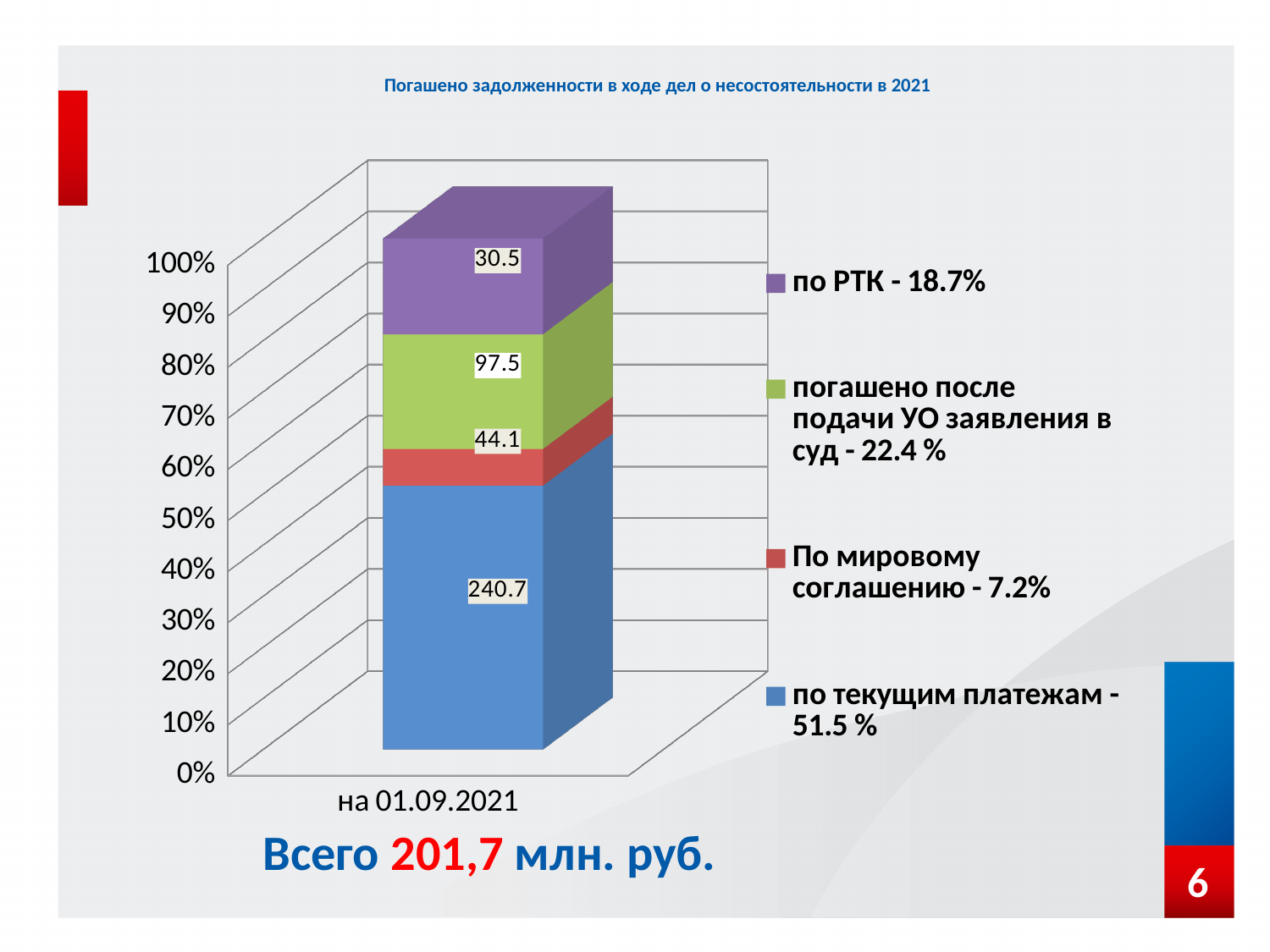
What is the data label for the 'погашено после подачи УО заявления в суд' segment? 97.5 What is the difference between the 'погашено после подачи УО заявления в суд' label (97.5) and the 'по РТК' label (30.5)? 67 What kind of chart is shown on the slide? Stacked bar chart Which is larger: the 'По мировому соглашению' label or the 'по РТК' label? По мировому соглашению Which series has the smallest data label in the stacked bar? по РТК What is the data label for the 'по РТК' segment of the stacked bar? 30.5 How many series does the legend list? 4 Which series has the largest data label in the stacked bar? по текущим платежам What is the data label for the 'по текущим платежам' segment of the stacked bar? 240.7 What percentage does the legend give for 'по текущим платежам'? 51.5 % How many categories are shown on the x axis? 1 What is the data label for the 'По мировому соглашению' segment? 44.1